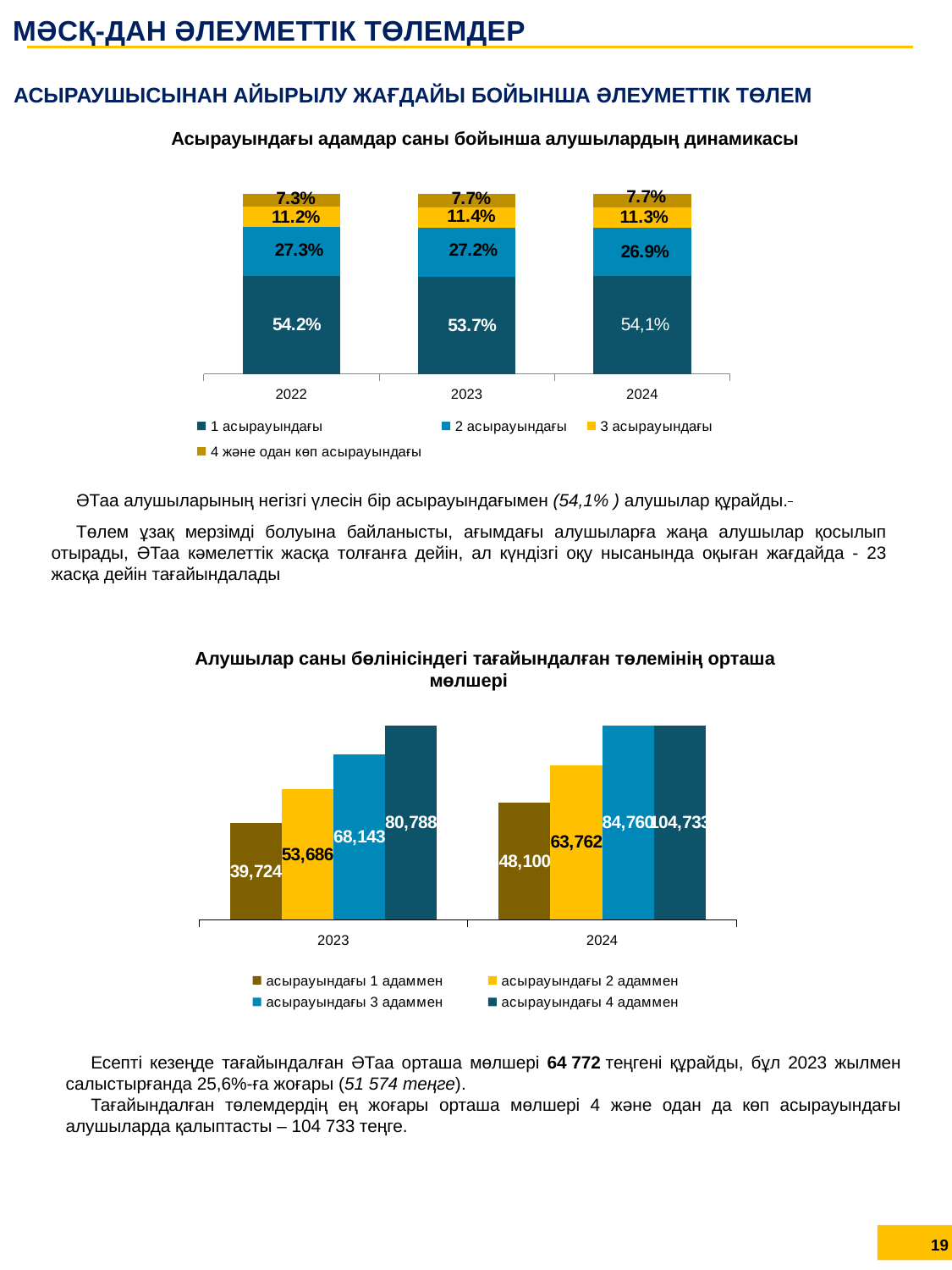
In the bottom chart, which is larger: 'асырауындағы 2 адаммен' in 2024 or 'асырауындағы 3 адаммен' in 2023? асырауындағы 3 адаммен in 2023 In the bottom chart (Алушылар саны бөлінісіндегі тағайындалған төлемінің орташа мөлшері), what is the value for 'асырауындағы 4 адаммен' in 2024? 104,733 In the top chart, how many series does the legend list? 4 In the top chart, what kind of chart is shown? Stacked bar chart In the top chart, which series has the largest share in 2023? 1 асырауындағы In the bottom chart, what is the difference between 'асырауындағы 3 адаммен' in 2024 and in 2023? 16,617 In the top chart, what is the value for '2 асырауындағы' in 2024? 26.9% In the bottom chart, how many year categories are shown on the x axis? 2 In the bottom chart, does the value for 'асырауындағы 1 адаммен' rise or fall from 2023 to 2024? Rise In the top chart (Асырауындағы адамдар саны бойынша алушылардың динамикасы), what is the value for '1 асырауындағы' in 2022? 54.2% In the bottom chart, what is the value for 'асырауындағы 1 адаммен' in 2023? 39,724 In the top chart, what is the value for '4 және одан көп асырауындағы' in 2023? 7.7%